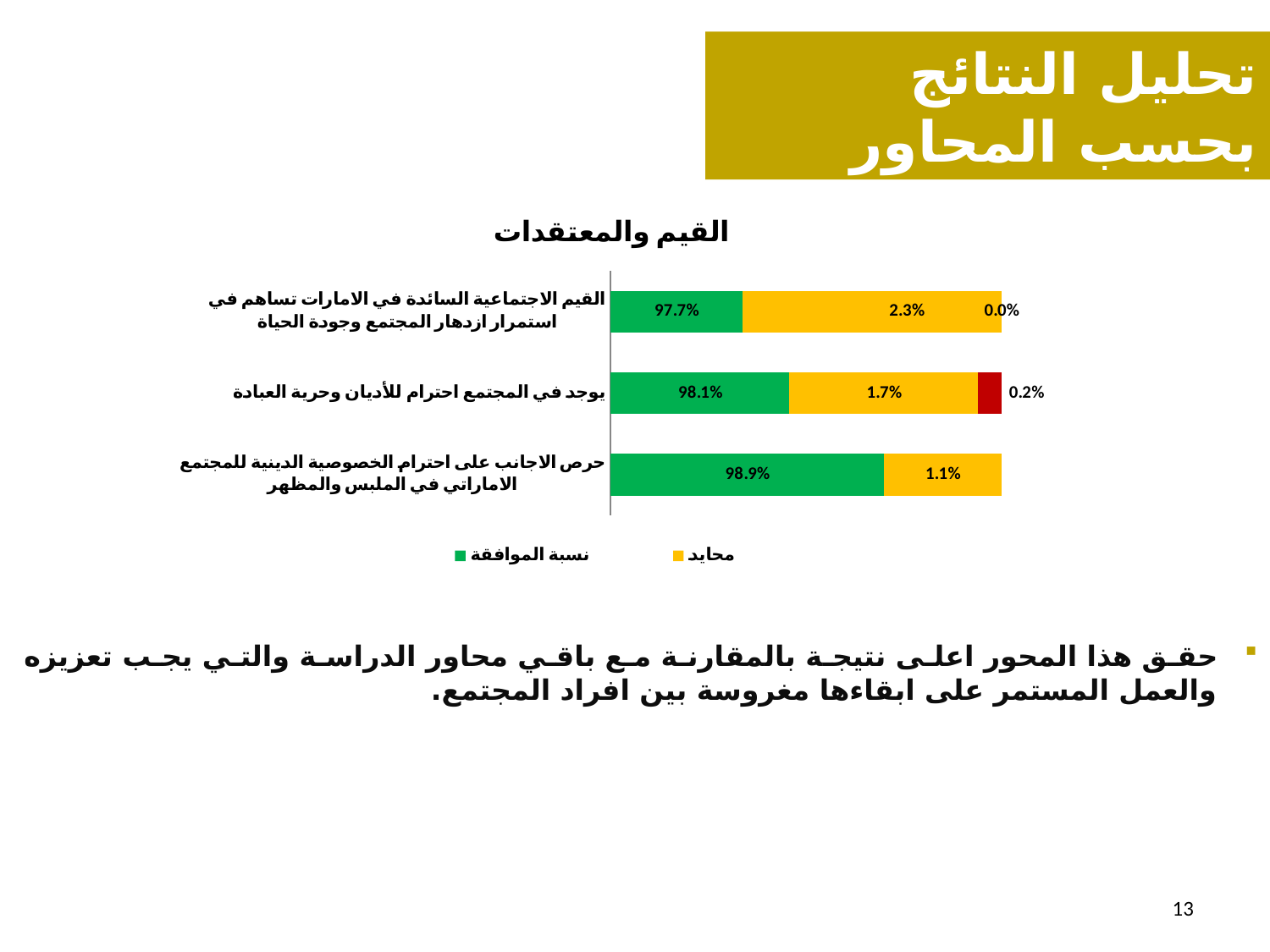
What is the value of نسبة الموافقة for the category 'يوجد في المجتمع احترام للأديان وحرية العبادة'? 98.1% What is the value of محايد for the category 'القيم الاجتماعية السائدة في الامارات تساهم في استمرار ازدهار المجتمع وجودة الحياة'? 2.3% Which is larger: the محايد value for 'يوجد في المجتمع احترام للأديان وحرية العبادة' or for 'حرص الاجانب على احترام الخصوصية الدينية للمجتمع الاماراتي في الملبس والمظهر'? يوجد في المجتمع احترام للأديان وحرية العبادة Which category has the highest نسبة الموافقة value? حرص الاجانب على احترام الخصوصية الدينية للمجتمع الاماراتي في الملبس والمظهر How many series does the chart legend list? 2 What colour represents the نسبة الموافقة series in the chart? Green What type of chart is shown on the slide? Stacked horizontal bar chart What is the difference between the نسبة الموافقة values for 'حرص الاجانب على احترام الخصوصية الدينية للمجتمع الاماراتي في الملبس والمظهر' and 'القيم الاجتماعية السائدة في الامارات تساهم في استمرار ازدهار المجتمع وجودة الحياة'? 1.2% What is the value of نسبة الموافقة for the category 'حرص الاجانب على احترام الخصوصية الدينية للمجتمع الاماراتي في الملبس والمظهر'? 98.9% Which category has the lowest نسبة الموافقة value? القيم الاجتماعية السائدة في الامارات تساهم في استمرار ازدهار المجتمع وجودة الحياة What is the title of the chart? القيم والمعتقدات How many categories (bars) does the chart show? 3